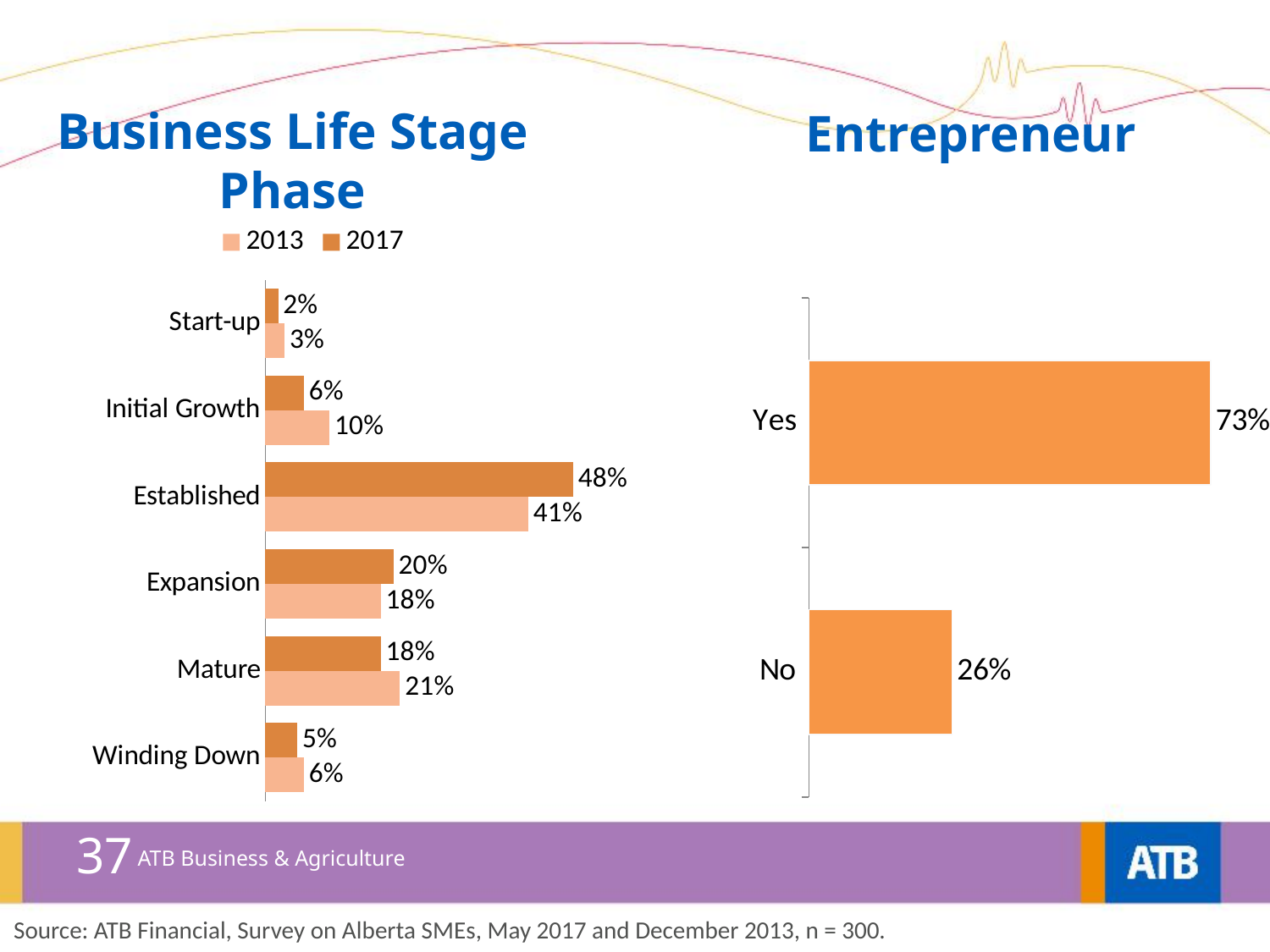
In the Business Life Stage Phase chart, what is the 2013 value for Initial Growth? 10% How many series does the legend of the Business Life Stage Phase chart list? 2 In the Business Life Stage Phase chart, what is the difference between the 2017 and 2013 values for Established? 7% In the Entrepreneur chart, what is the value for Yes? 73% What kind of chart is the Entrepreneur chart? Bar chart In the Business Life Stage Phase chart, which is larger for Mature: the 2013 value or the 2017 value? 2013 In the Business Life Stage Phase chart, which category has the lowest 2013 value? Start-up In the Business Life Stage Phase chart, which category has the highest 2017 value? Established In the Entrepreneur chart, what is the difference between the Yes and No values? 47% What are the two series named in the legend of the Business Life Stage Phase chart? 2013 and 2017 How many categories does the Business Life Stage Phase chart show? 6 In the Business Life Stage Phase chart, what is the 2017 value for Established? 48%